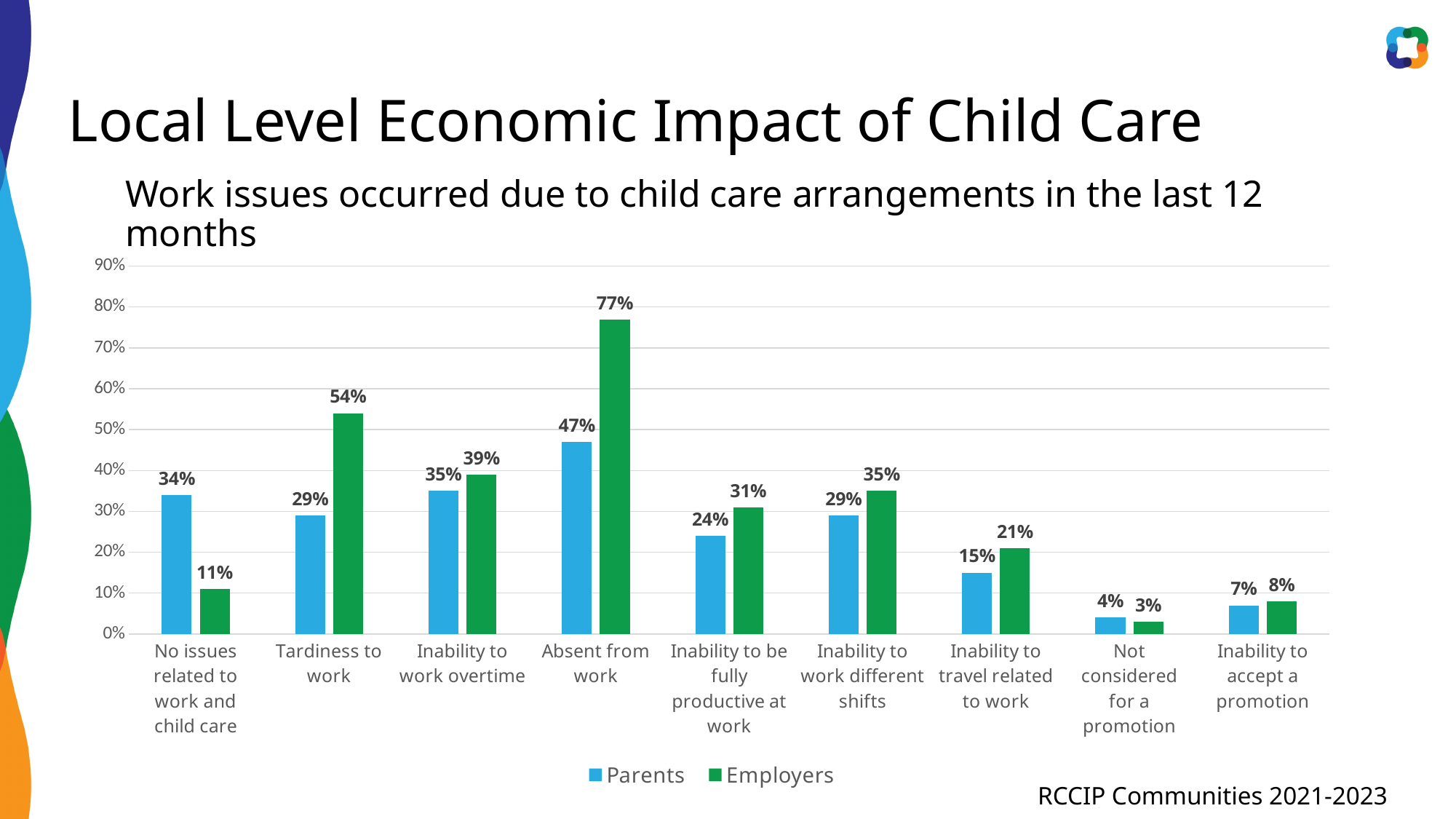
For 'No issues related to work and child care', which series has the larger value, Parents or Employers? Parents What is the difference between the Employers and Parents values for 'Tardiness to work'? 25% Is the Parents value for 'Absent from work' greater or less than 40%? greater What percentage of Parents reported 'Inability to travel related to work'? 15% Which category has the highest value for the Employers series? Absent from work What kind of chart is shown on the slide? Bar chart What is the chart's title? Work issues occurred due to child care arrangements in the last 12 months Which category has the lowest value for the Parents series? Not considered for a promotion Which colour represents the Employers series? Green How many categories are shown on the x axis? 9 What percentage of Employers reported 'Absent from work'? 77% How many series does the legend list? 2